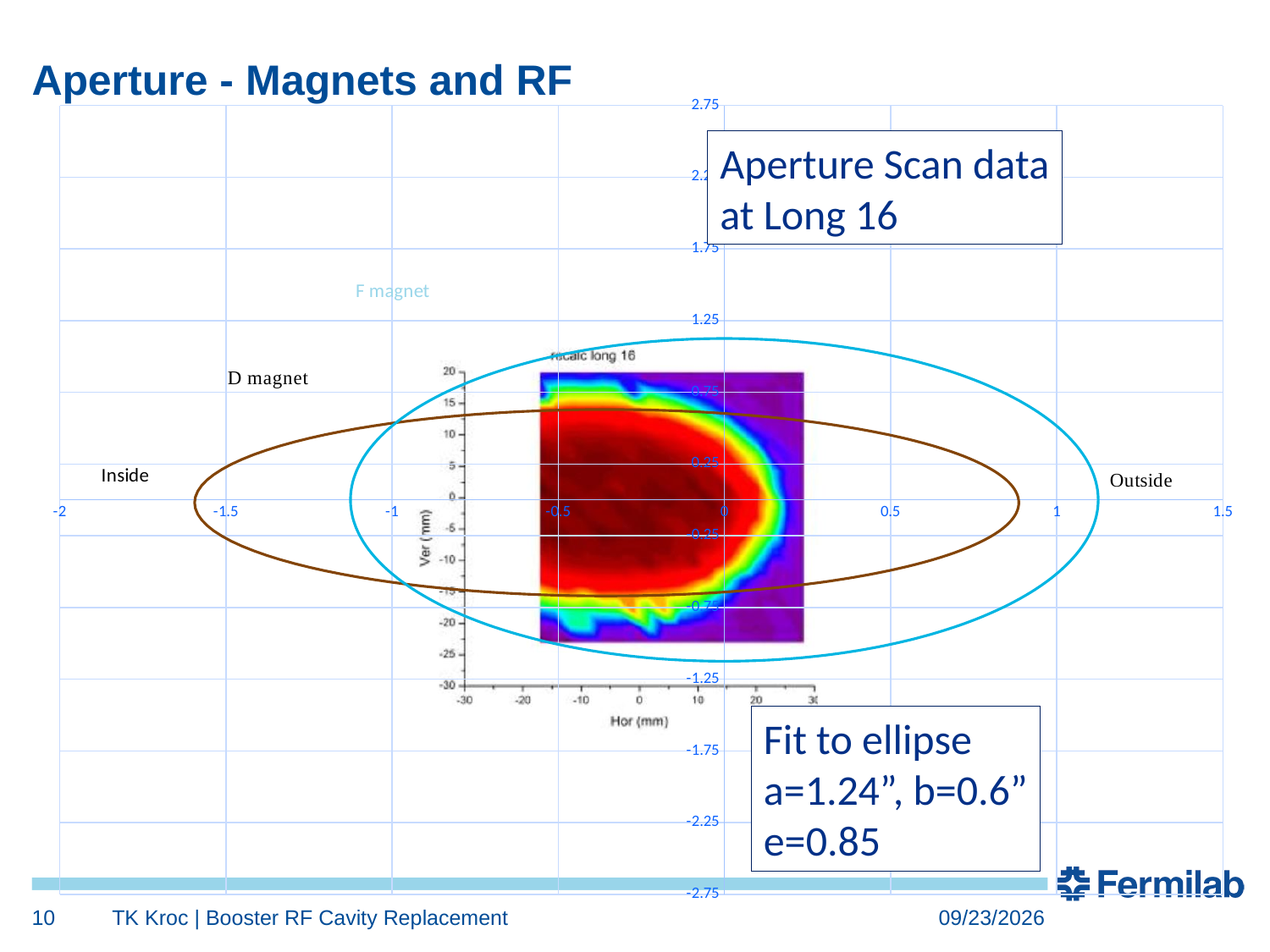
What kind of chart is shown on the slide? scatter (XY) chart What is the lowest value shown on the horizontal axis? -2 What is the highest value shown on the horizontal axis? 1.5 According to the fit-to-ellipse box, what is the value of e? 0.85 According to the fit-to-ellipse box, what is the value of a? 1.24" What is the highest value shown on the vertical axis? 2.75 On which side of the chart is the label "Inside" placed? left